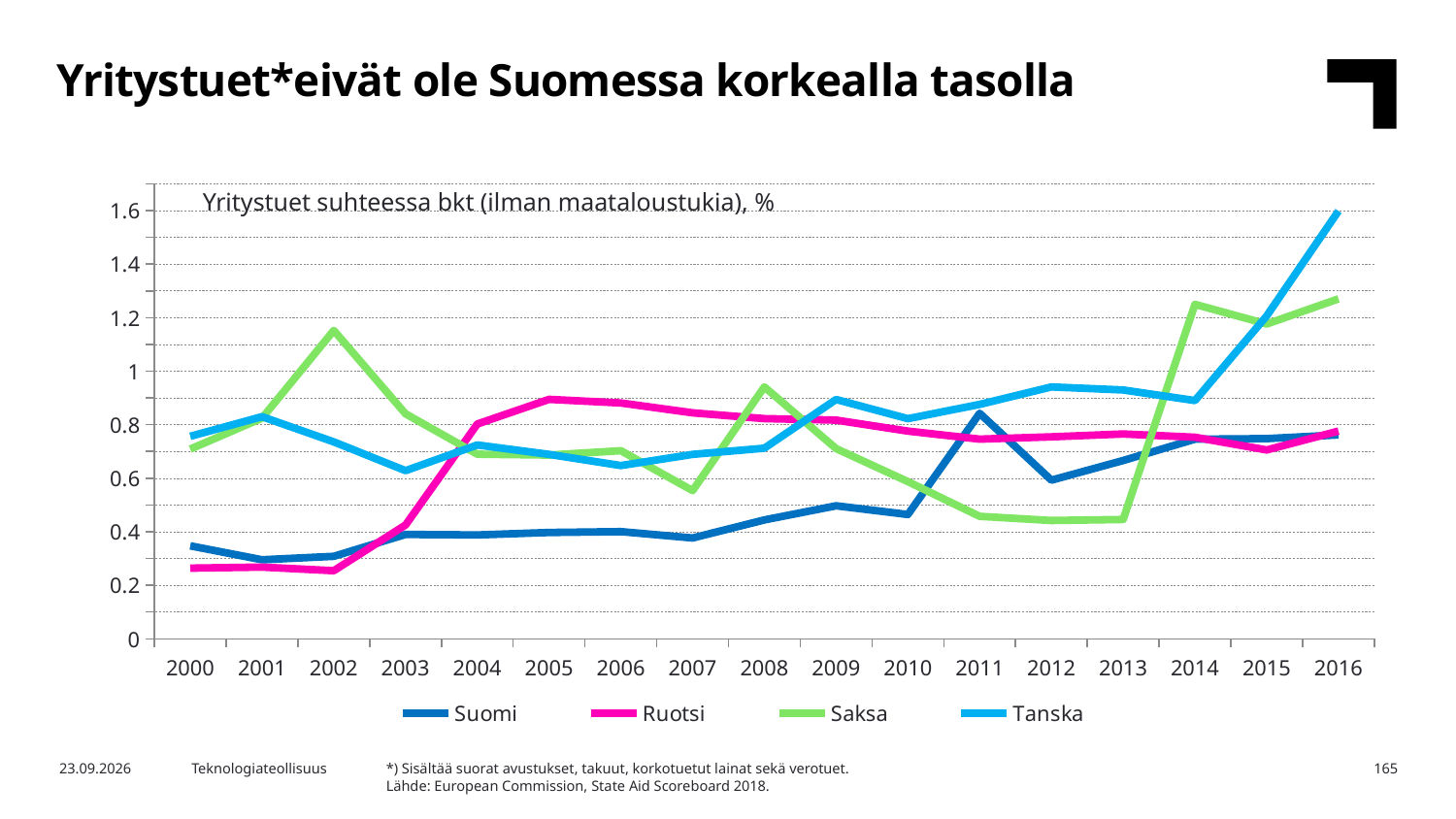
Is the value for Tanska in 2016 greater or less than 1.4? greater In 2016, which series has the higher value, Tanska or Saksa? Tanska Is the value for Suomi in 2000 greater or less than 0.4? less How many series does the legend list? 4 Is the value for Ruotsi in 2000 greater or less than 0.4? less How many years are shown on the x axis? 17 What is the title printed inside the chart area? Yritystuet suhteessa bkt (ilman maataloustukia), % In 2005, which series has the higher value, Ruotsi or Suomi? Ruotsi Which series has the lowest value in 2013? Saksa What type of chart is shown on the slide? line chart Which series has the highest value in 2002? Saksa